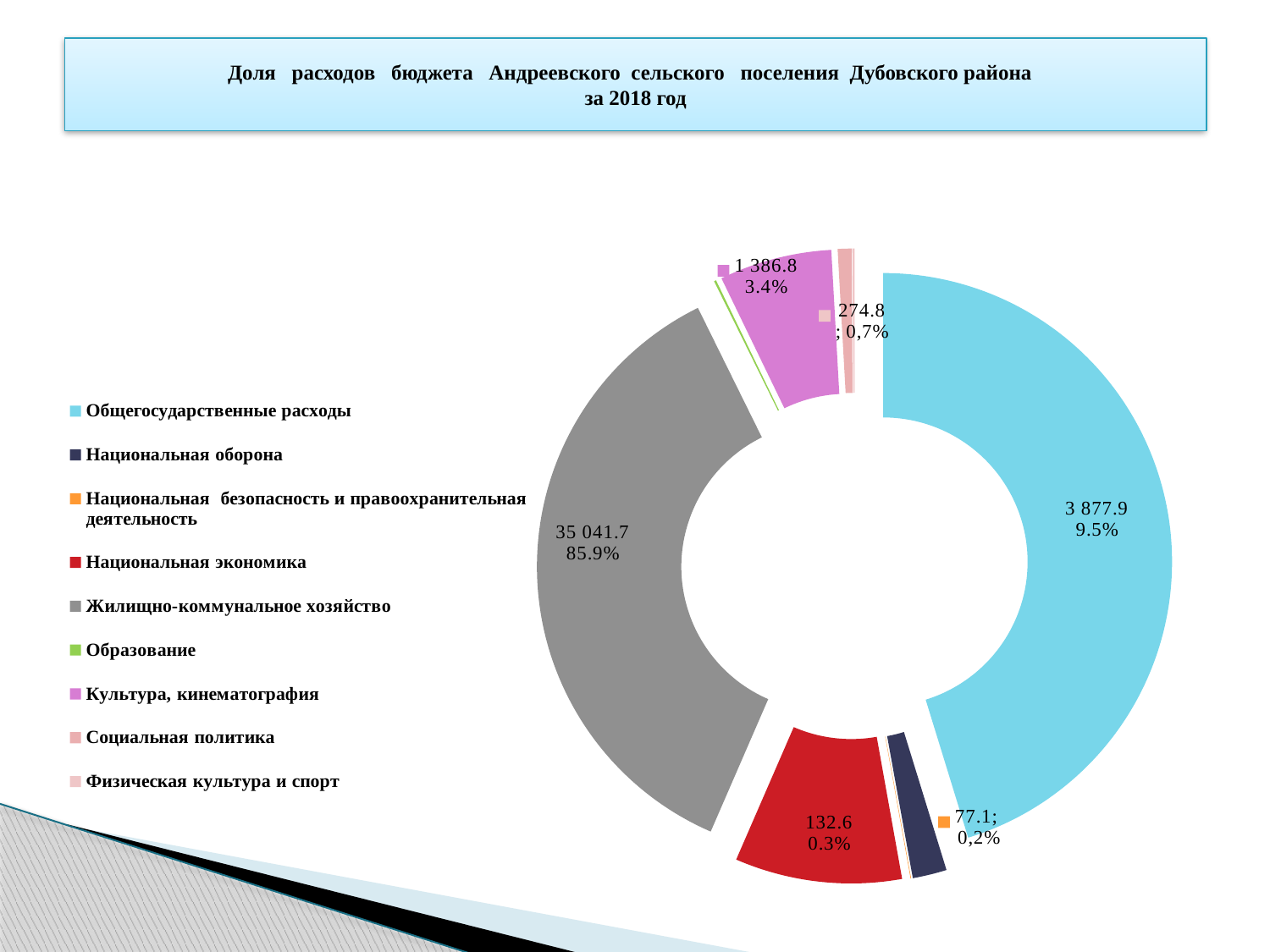
How many categories does the legend list? 9 What share of the pie does Жилищно-коммунальное хозяйство have? 85.9% What kind of chart is shown on the slide? Pie chart (doughnut) What share of the pie does Культура, кинематография have? 3.4% What value is shown for Жилищно-коммунальное хозяйство? 35 041.7 Which is larger, the value for Общегосударственные расходы or the value for Культура, кинематография? Общегосударственные расходы What value is shown for Социальная политика? 274.8 What share of the pie does Общегосударственные расходы have? 9.5% What value is shown for Общегосударственные расходы? 3 877.9 What value is shown for Культура, кинематография? 1 386.8 What value is shown for Национальная безопасность и правоохранительная деятельность? 77.1